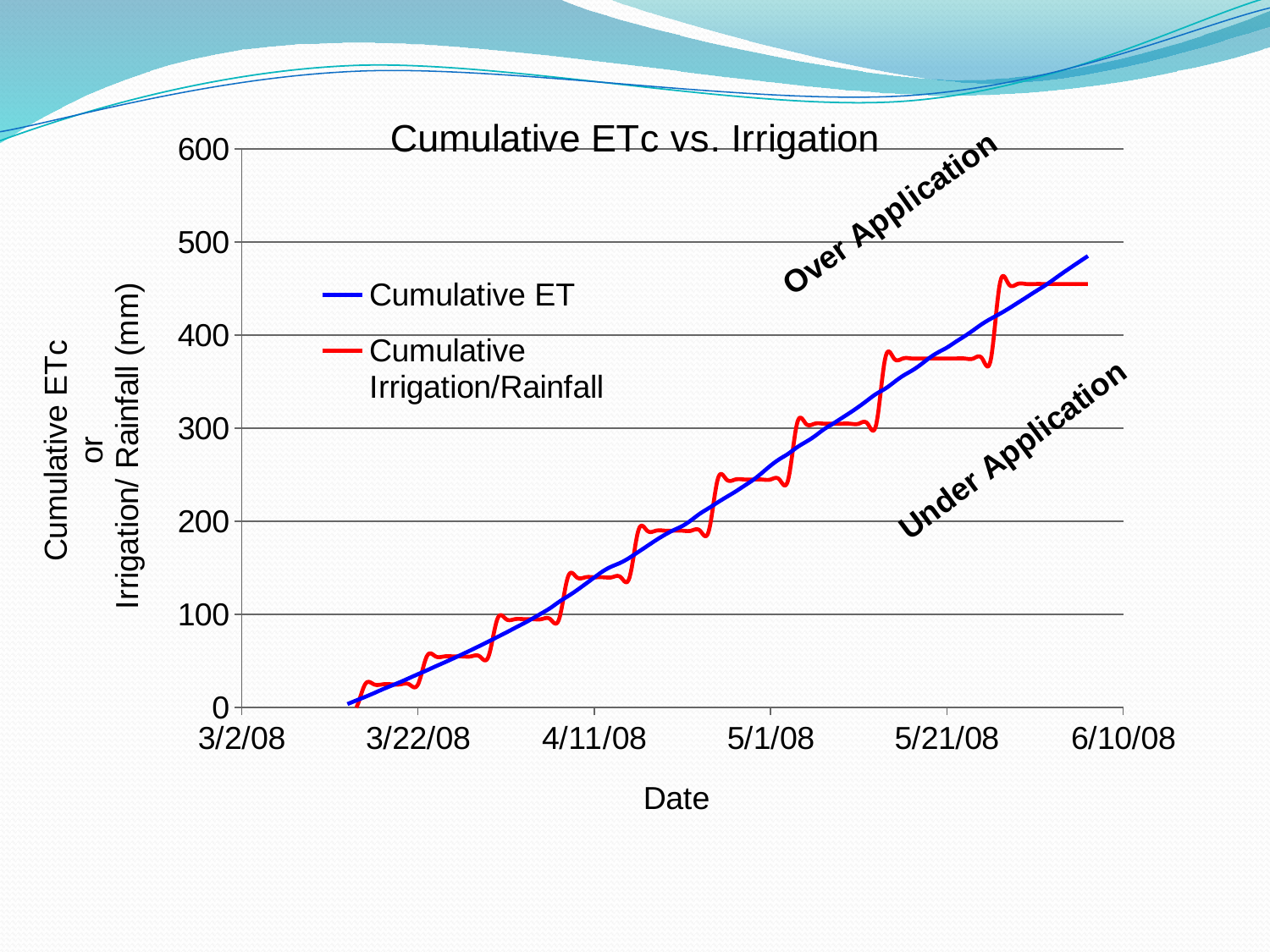
How many date labels are shown on the x axis? 6 Is the Cumulative ET value at 4/11/08 greater or less than 200? less Does the Cumulative Irrigation/Rainfall line generally rise or fall from 3/22/08 to 6/10/08? rise Which series is drawn in red? Cumulative Irrigation/Rainfall Is the final value of the Cumulative Irrigation/Rainfall line greater or less than 500? less What is the title of the chart? Cumulative ETc vs. Irrigation Is the Cumulative ET value at 4/11/08 greater or less than 100? greater How many series does the legend list? 2 What kind of chart is shown on the slide? line chart Does the Cumulative ET line rise or fall as the date increases? rise